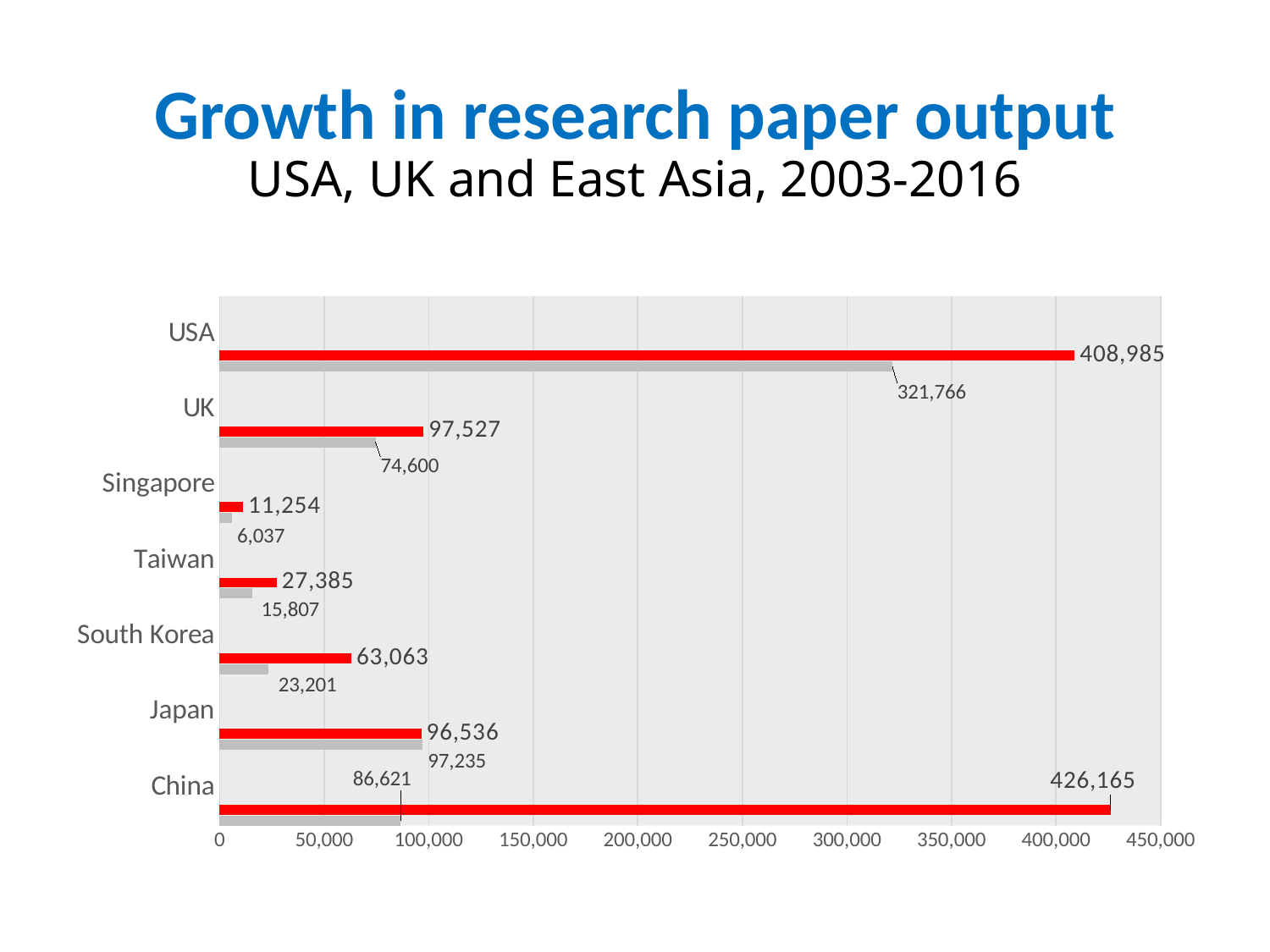
What is the value of the grey bar for Taiwan? 15,807 Is the grey bar value for the USA greater or less than 300,000? greater What is the value of the grey bar for the UK? 74,600 Which country has the highest red bar value? China What is the title of the slide? Growth in research paper output What type of chart is shown on the slide? Bar chart What is the value of the red bar for South Korea? 63,063 What is the value of the red bar for the USA? 408,985 How many countries are shown on the chart? 7 For Japan, which is larger: the red bar value or the grey bar value? The grey bar value (97,235) Which country has the lowest grey bar value? Singapore What is the difference between the red and grey bar values for China? 339,544